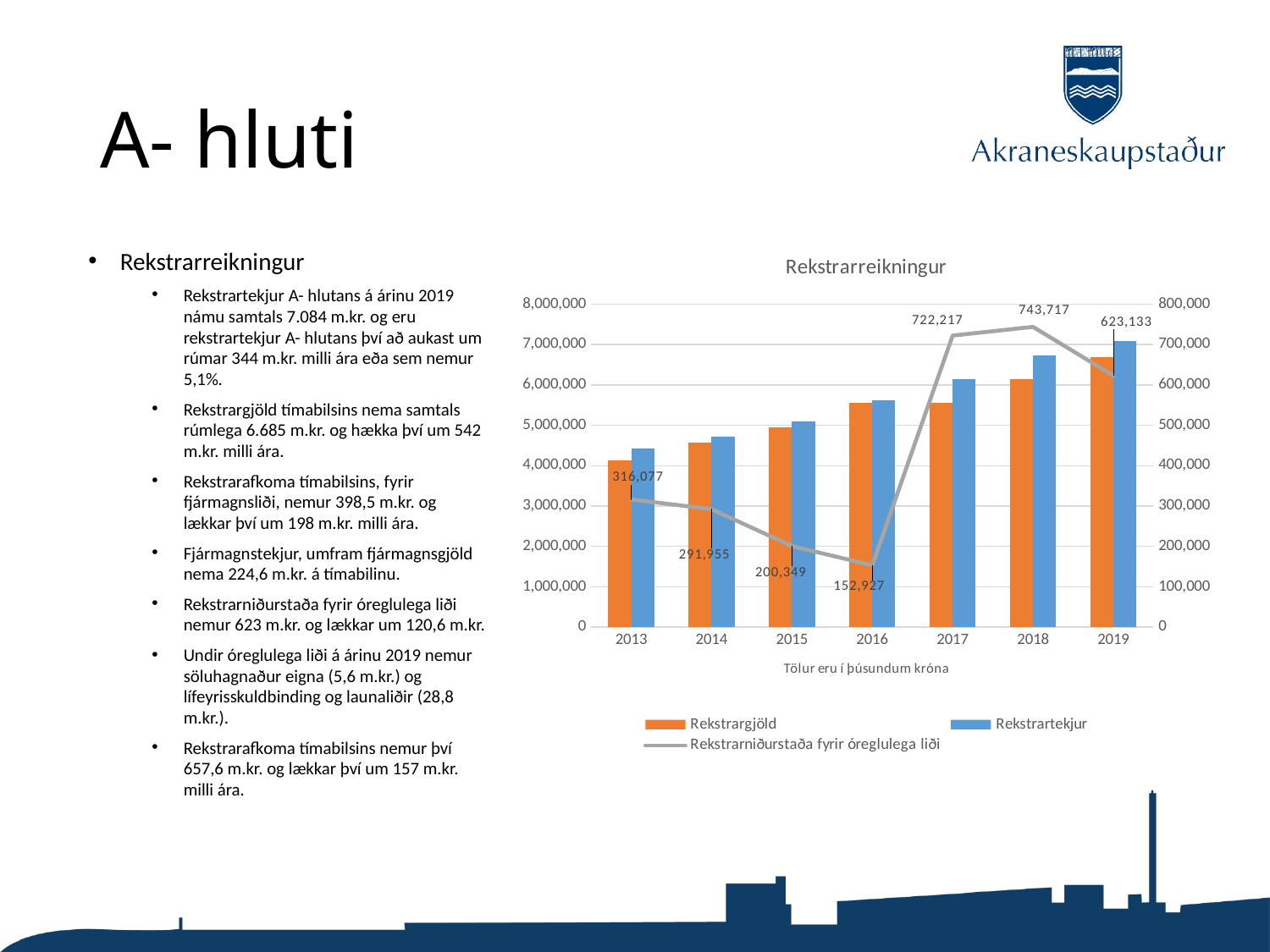
By how much did Rekstrarniðurstaða fyrir óreglulega liði fall from 2018 to 2019? 120,584 How many series does the chart legend list? 3 What is the value of Rekstrarniðurstaða fyrir óreglulega liði for 2016? 152,927 In which year is Rekstrarniðurstaða fyrir óreglulega liði highest? 2018 In 2019, which is larger: Rekstrargjöld or Rekstrartekjur? Rekstrartekjur In which year is Rekstrarniðurstaða fyrir óreglulega liði lowest? 2016 What is the difference between Rekstrarniðurstaða fyrir óreglulega liði in 2018 and 2017? 21,500 How many years are shown on the x axis of the chart? 7 Is the Rekstrargjöld value for 2014 greater or less than 5,000,000? less What is the value of Rekstrarniðurstaða fyrir óreglulega liði for 2013? 316,077 What is the value of Rekstrarniðurstaða fyrir óreglulega liði for 2019? 623,133 Is the Rekstrartekjur value for 2018 greater or less than 6,000,000? greater